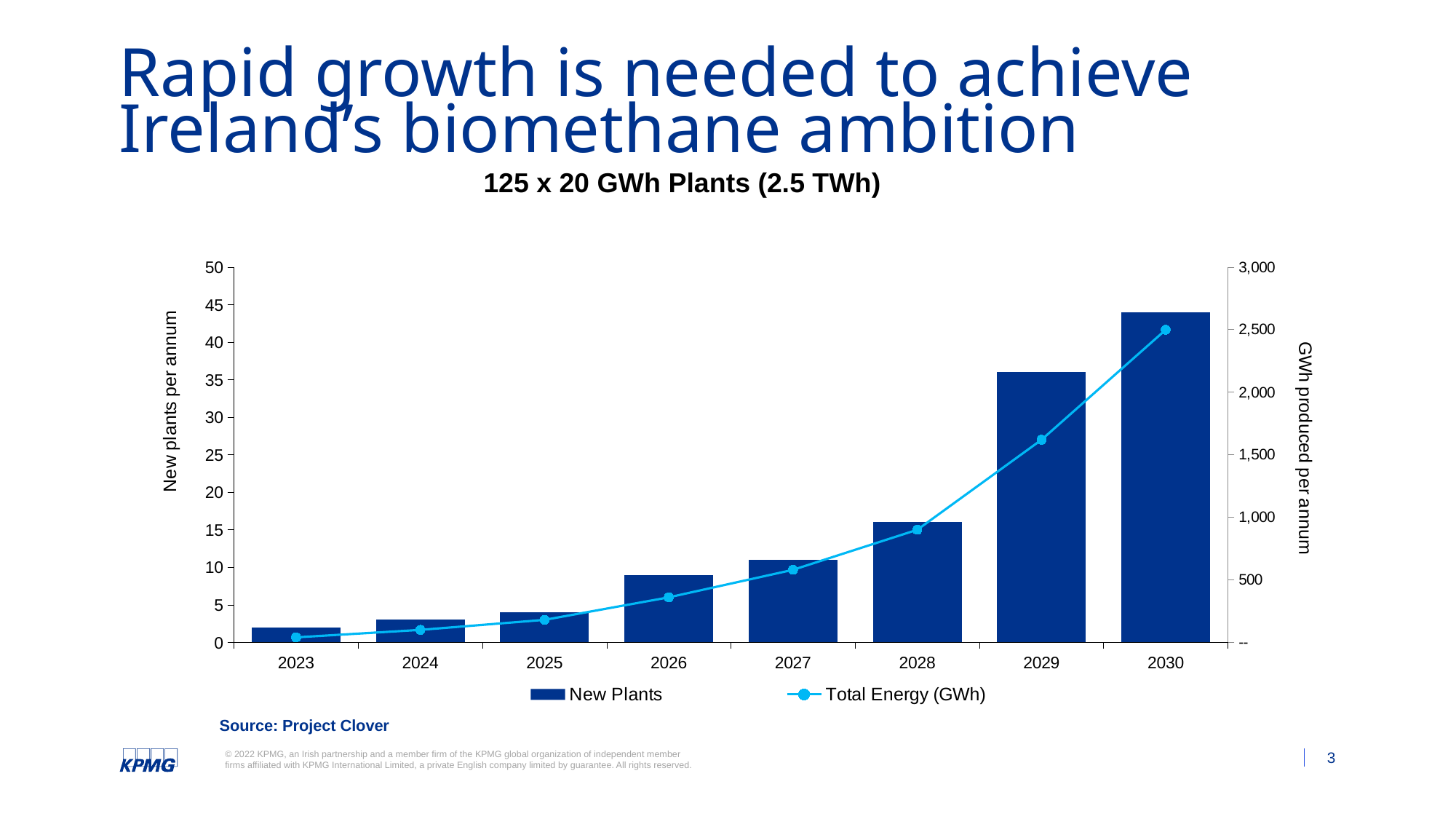
Which year has the lowest number of new plants? 2023 Which year has the highest number of new plants? 2030 Which year has more new plants, 2027 or 2028? 2028 Is the total energy produced in 2028 greater or less than 1,000 GWh? less Do the values for Total Energy (GWh) rise or fall from 2023 to 2030? rise How many series does the chart legend list? 2 What kind of chart is shown on the slide? Combined bar and line chart Is the number of new plants in 2029 greater or less than 30? greater What is the title of the right-hand vertical axis? GWh produced per annum Is the total energy produced in 2029 greater or less than 1,500 GWh? greater How many years are shown on the x axis of the chart? 8